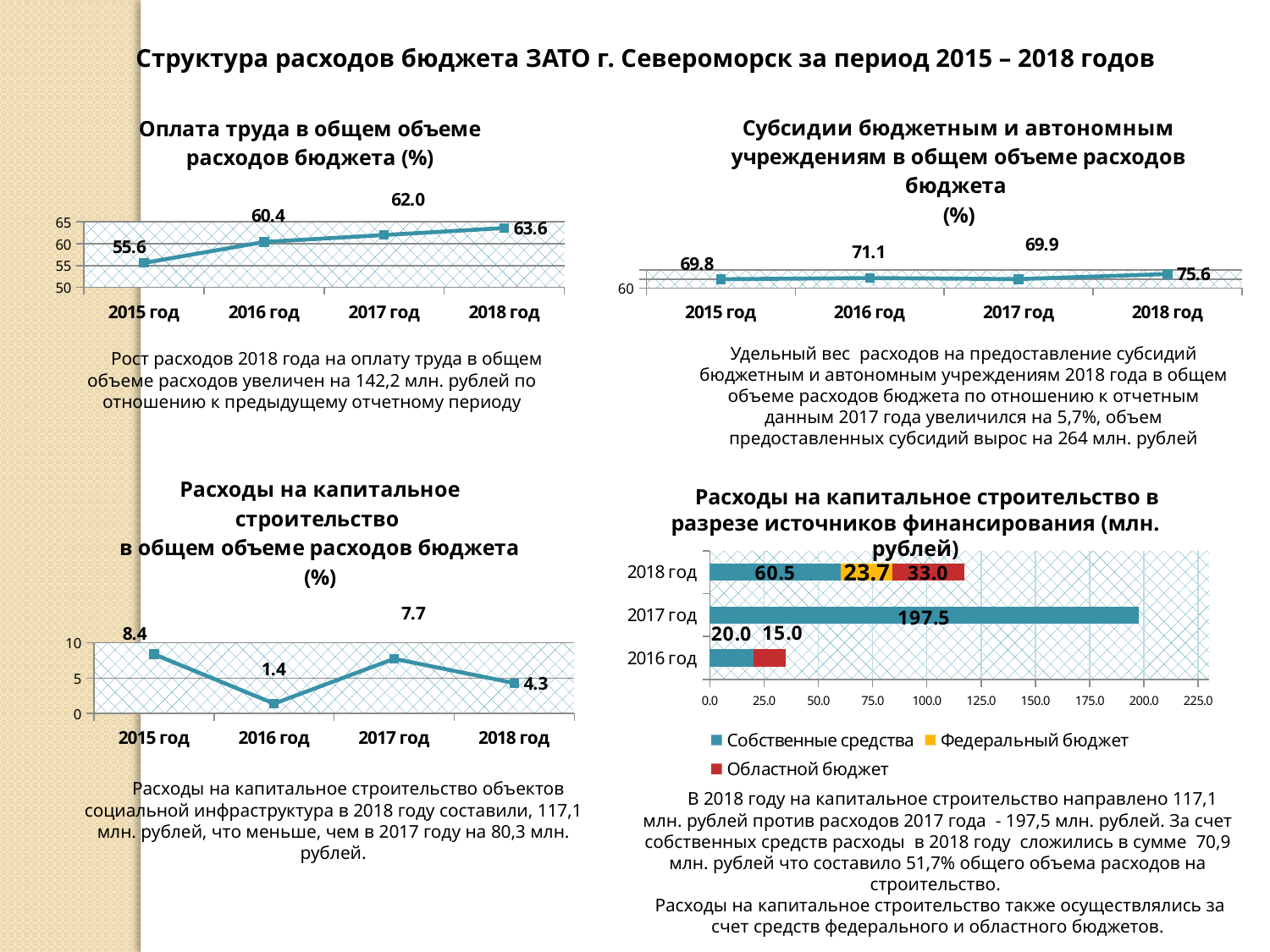
On the chart 'Субсидии бюджетным и автономным учреждениям в общем объеме расходов бюджета (%)', how many years are plotted? 4 On the chart 'Расходы на капитальное строительство в разрезе источников финансирования (млн. рублей)', what is the total of the stacked bar for 2016 год? 35.0 On the chart 'Субсидии бюджетным и автономным учреждениям в общем объеме расходов бюджета (%)', what is the value for 2017 год? 69.9 What kind of chart is 'Расходы на капитальное строительство в разрезе источников финансирования (млн. рублей)'? bar chart On the chart 'Расходы на капитальное строительство в разрезе источников финансирования (млн. рублей)', how many series does the legend list? 3 On the chart 'Субсидии бюджетным и автономным учреждениям в общем объеме расходов бюджета (%)', which year has the highest value? 2018 год On the chart 'Расходы на капитальное строительство в общем объеме расходов бюджета (%)', which year has the lowest value? 2016 год On the chart 'Оплата труда в общем объеме расходов бюджета (%)', do the values rise or fall from 2015 год to 2018 год? rise On the chart 'Оплата труда в общем объеме расходов бюджета (%)', what is the difference between the 2018 год and 2015 год values? 8.0 On the chart 'Расходы на капитальное строительство в разрезе источников финансирования (млн. рублей)', what is the value of Собственные средства for 2018 год? 60.5 On the chart 'Расходы на капитальное строительство в общем объеме расходов бюджета (%)', what is the value for 2017 год? 7.7 On the chart 'Оплата труда в общем объеме расходов бюджета (%)', what is the value for 2015 год? 55.6